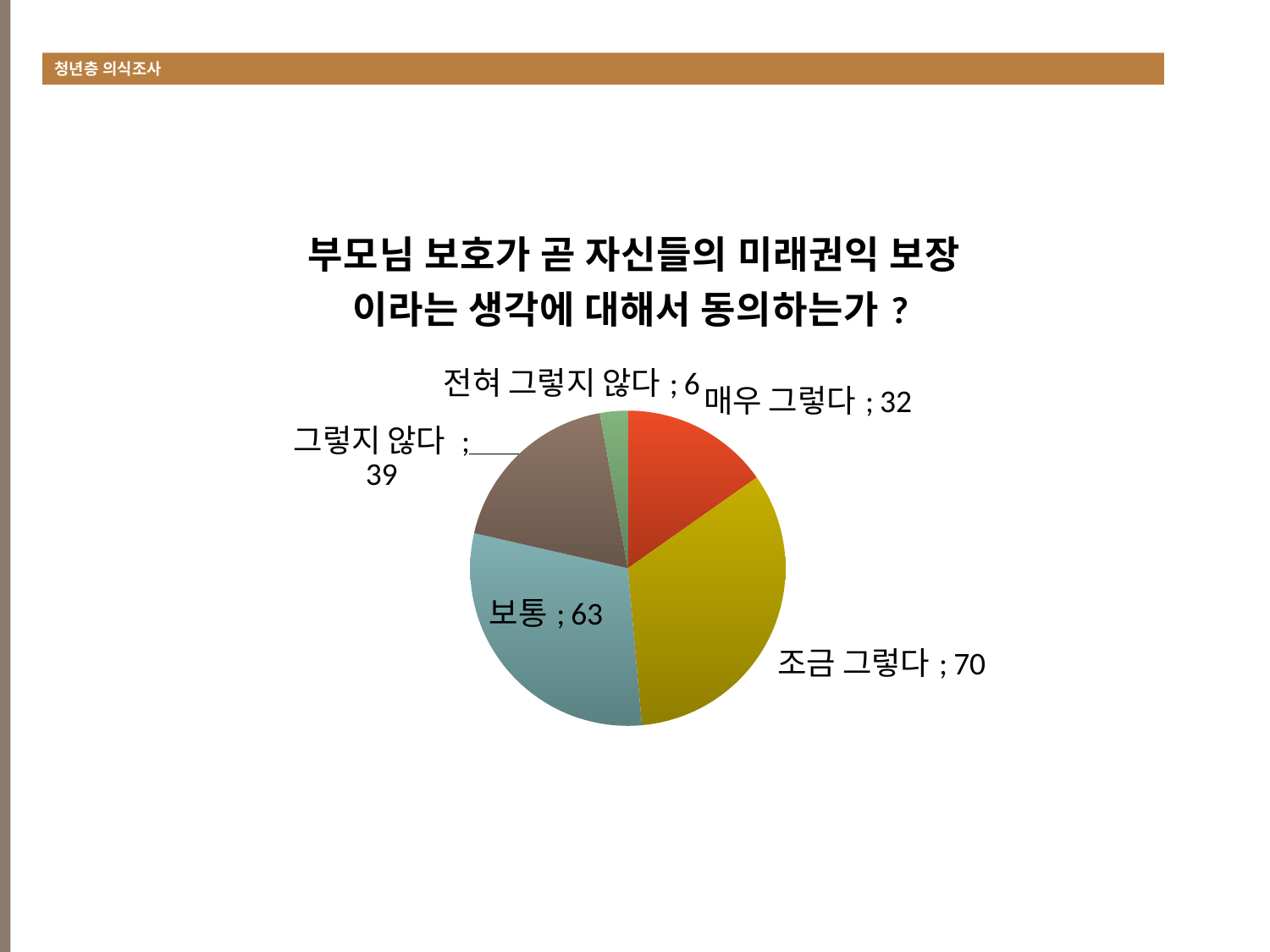
Which category has the largest slice in the pie chart? 조금 그렇다 What is the difference between the values for 조금 그렇다 and 보통? 7 What is the difference between the values for 그렇지 않다 and 매우 그렇다? 7 Which category has the smallest slice in the pie chart? 전혀 그렇지 않다 Which is larger, the value for 그렇지 않다 or the value for 매우 그렇다? 그렇지 않다 How many categories does the pie chart show? 5 What is the value for 보통 in the pie chart? 63 What is the value for 매우 그렇다 in the pie chart? 32 What is the value for 전혀 그렇지 않다 in the pie chart? 6 What is the total of all the values shown in the pie chart? 210 What is the value for 조금 그렇다 in the pie chart? 70 What type of chart is shown on the slide? Pie chart